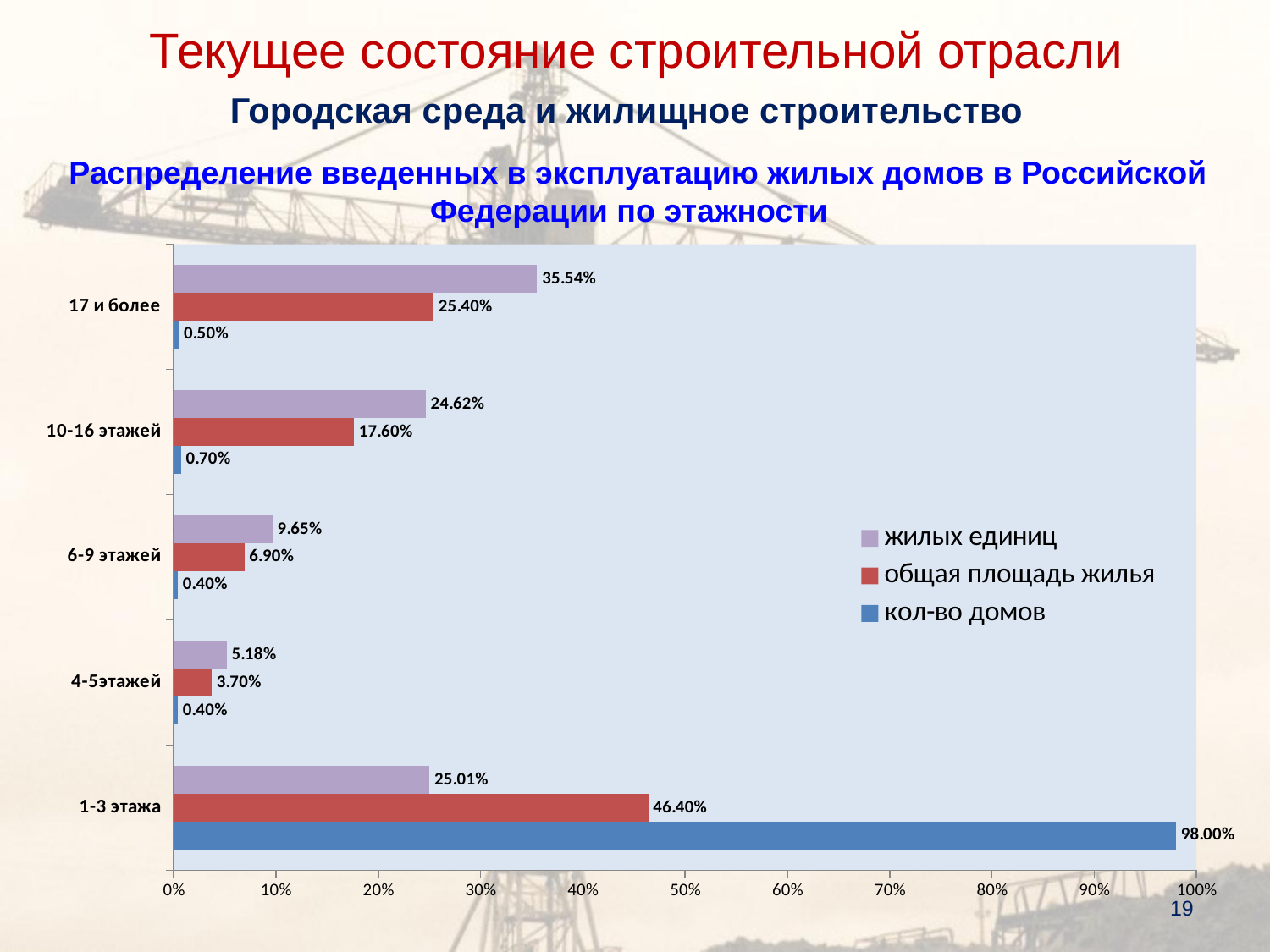
Which is larger for '1-3 этажа': 'жилых единиц' or 'общая площадь жилья'? общая площадь жилья How many series does the legend list? 3 What is the value of 'кол-во домов' for '1-3 этажа'? 98.00% Is the value of 'кол-во домов' for '1-3 этажа' greater or less than 90%? greater What is the value of 'жилых единиц' for '17 и более'? 35.54% Which colour represents 'кол-во домов' in the legend? blue How many floor categories are shown on the chart? 5 What is the difference between 'жилых единиц' and 'общая площадь жилья' for '17 и более'? 10.14% Which category has the highest value for 'общая площадь жилья'? 1-3 этажа Which category has the lowest value for 'жилых единиц'? 4-5этажей What kind of chart is shown on the slide? bar chart What is the value of 'общая площадь жилья' for '10-16 этажей'? 17.60%